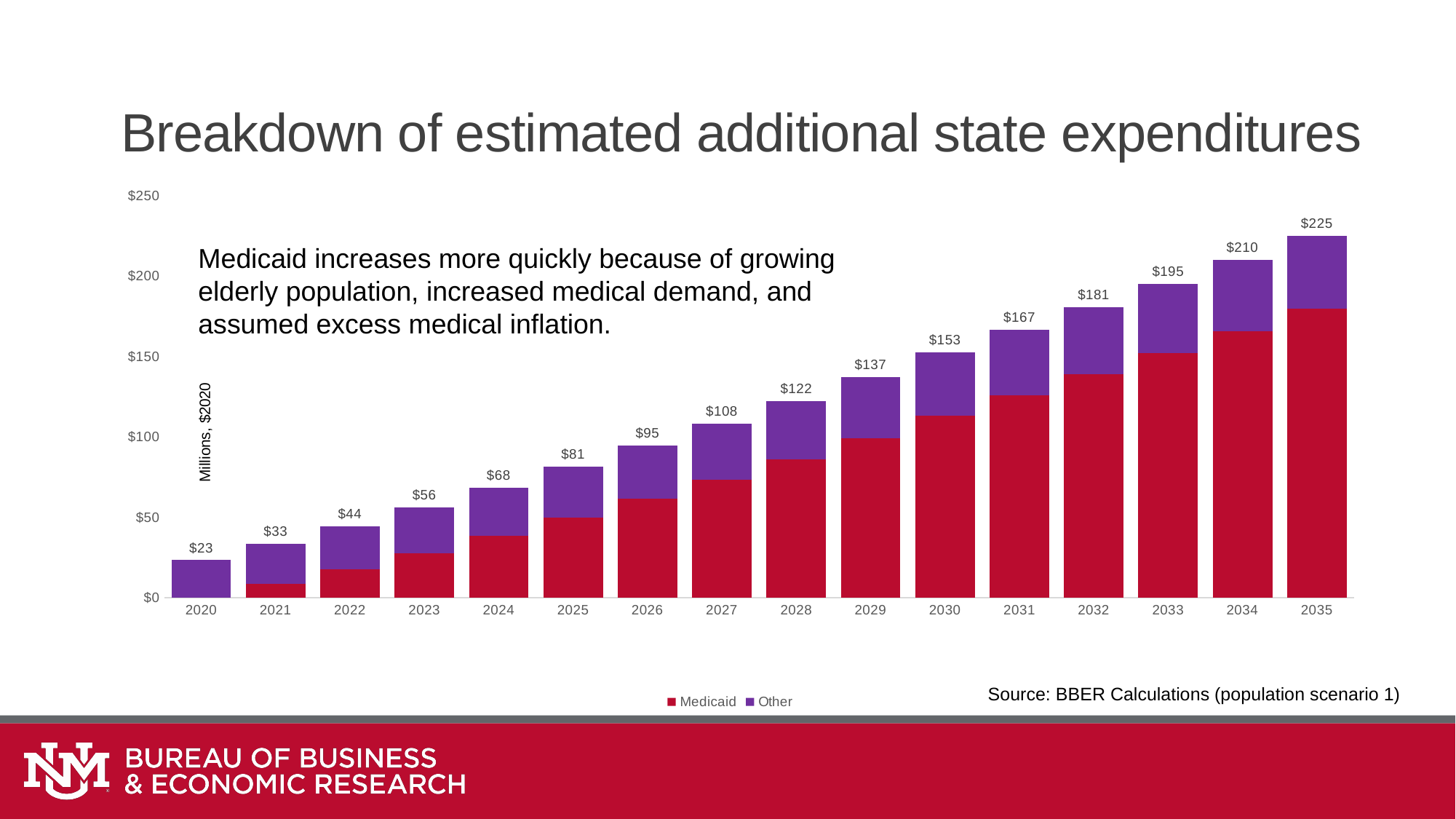
What is the total value labeled on the bar for 2028? $122 How many series does the legend list? 2 What is the total estimated additional state expenditure for 2035? $225 What kind of chart is shown on the slide? Stacked bar chart Do the total values rise or fall from 2020 to 2035? Rise Which year has the lowest total additional state expenditure? 2020 Is the Medicaid value for 2024 greater or less than $50? less What is the difference between the total for 2030 and the total for 2025? $72 Is the Medicaid value for 2035 greater or less than $150? greater How many years are shown on the x axis? 16 Which year has a larger total, 2027 or 2029? 2029 Which year has the highest total additional state expenditure? 2035